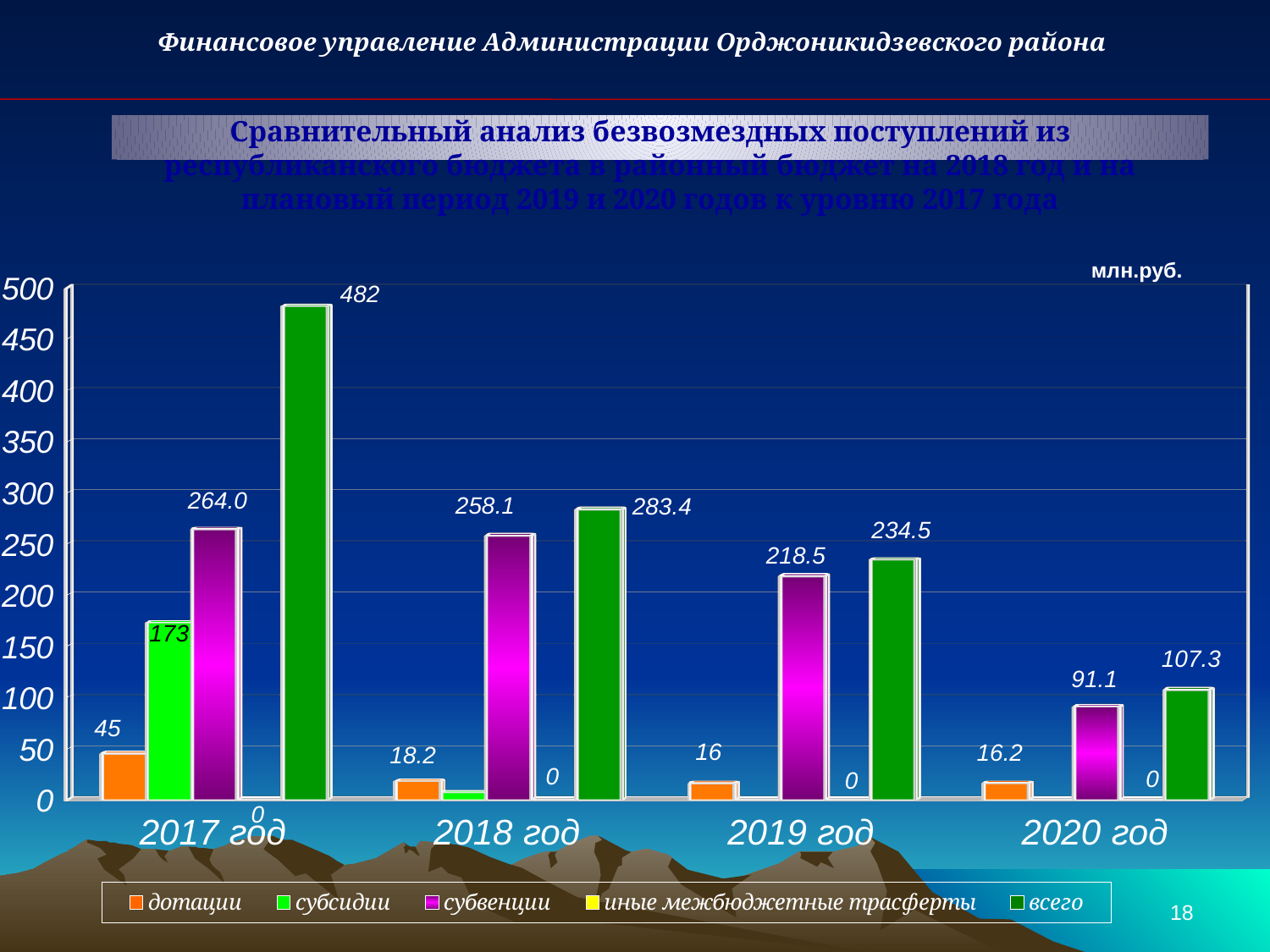
What is the value of субсидии for 2017 год? 173 How many year categories are shown on the x axis? 4 What is the value of дотации for 2020 год? 16.2 What is the difference between всего for 2018 год and всего for 2019 год? 48.9 Which is larger: субвенции for 2019 год or субвенции for 2020 год? субвенции for 2019 год In which year is the всего bar the lowest? 2020 год In which year is the всего bar the highest? 2017 год What is the value of субвенции for 2018 год? 258.1 How many series does the legend list? 5 What kind of chart is shown on the slide? bar chart What is the value of всего for 2017 год? 482 Is the value of субвенции for 2017 год greater or less than 250? greater